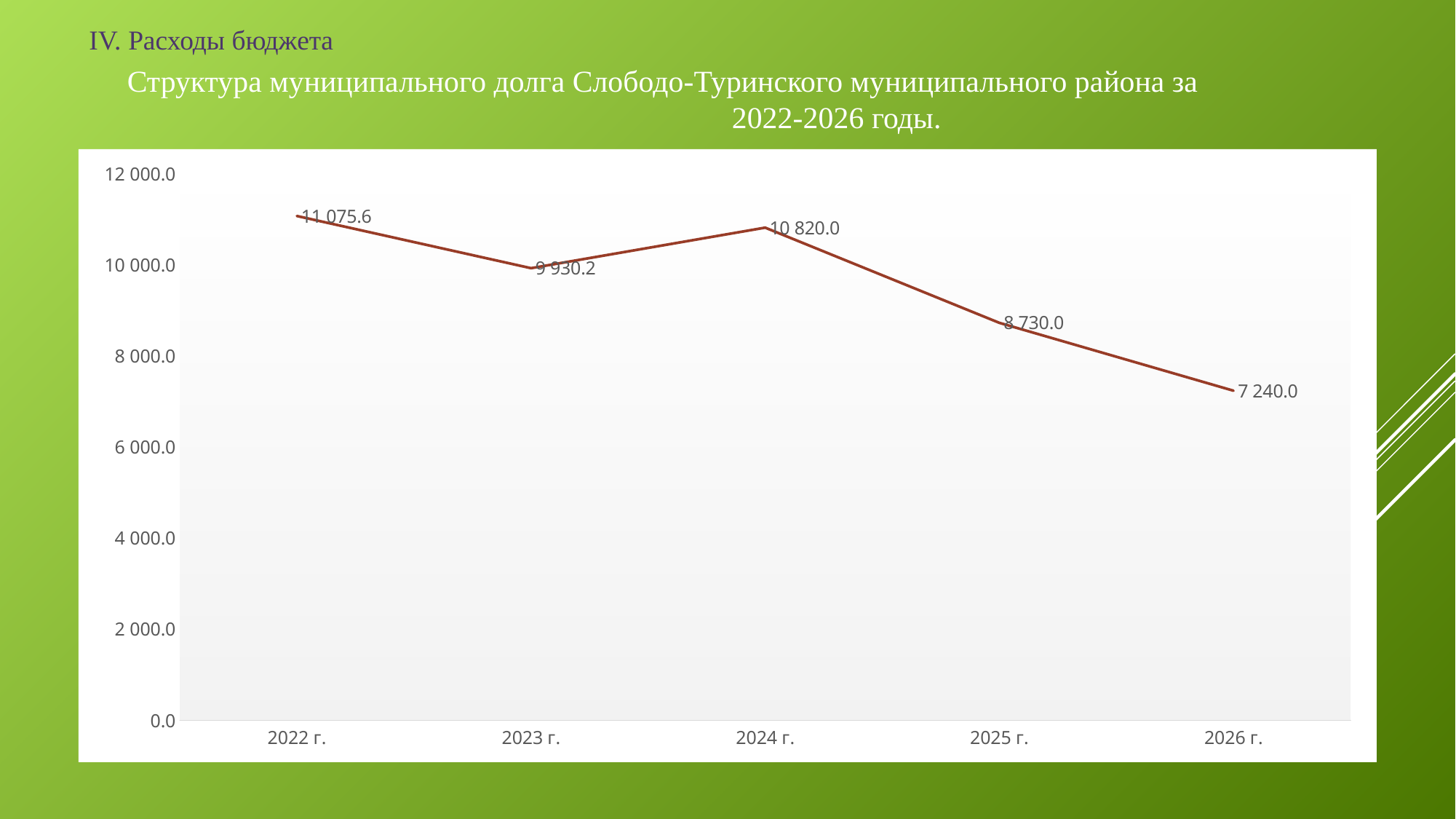
What is the value for 2022 г.? 11 075.6 Which year has the highest value? 2022 г. What is the value for 2026 г.? 7 240.0 Do the values generally rise or fall from 2022 г. to 2026 г.? fall Is the value for 2025 г. greater or less than 10 000.0? less Which year has the lowest value? 2026 г. How many years are plotted on the chart? 5 What is the difference between the values for 2022 г. and 2023 г.? 1 145.4 What is the difference between the values for 2024 г. and 2025 г.? 2 090.0 Which is larger, the value for 2023 г. or the value for 2024 г.? 2024 г. What kind of chart is shown on the slide? line chart What is the value for 2024 г.? 10 820.0